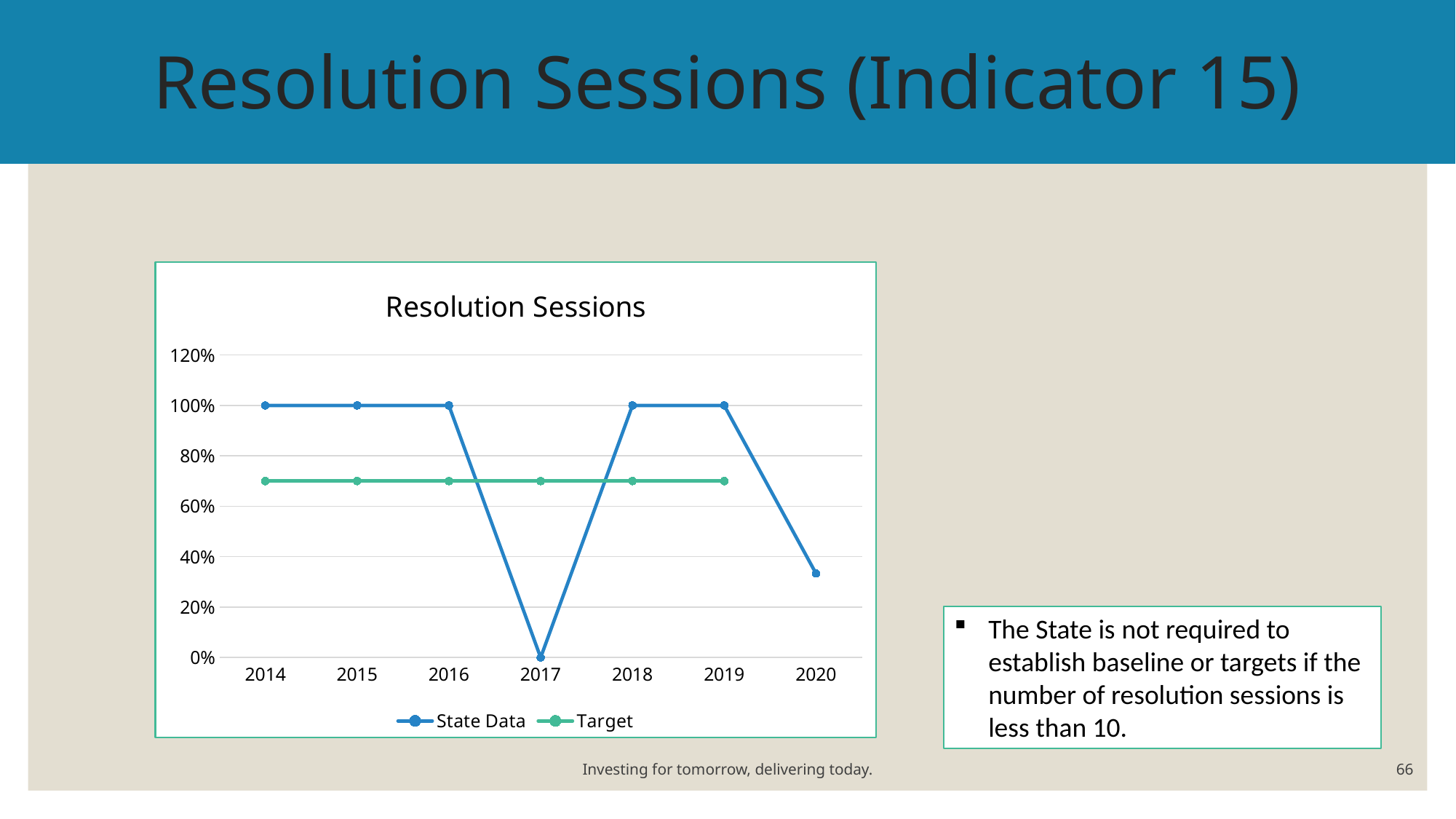
In 2016, which is larger: State Data or Target? State Data What kind of chart is shown on the slide? line chart Is the Target value for 2015 greater or less than 80%? less How many series does the chart legend list? 2 What is the State Data value for 2017? 0% What is the difference between the State Data values for 2016 and 2017? 100% In which year is the State Data value lowest? 2017 Does the State Data line rise or fall from 2019 to 2020? fall What are the two entries in the chart legend? State Data and Target Is the State Data value for 2020 greater or less than 40%? less What is the State Data value for 2014? 100% How many years are shown on the x axis of the chart? 7